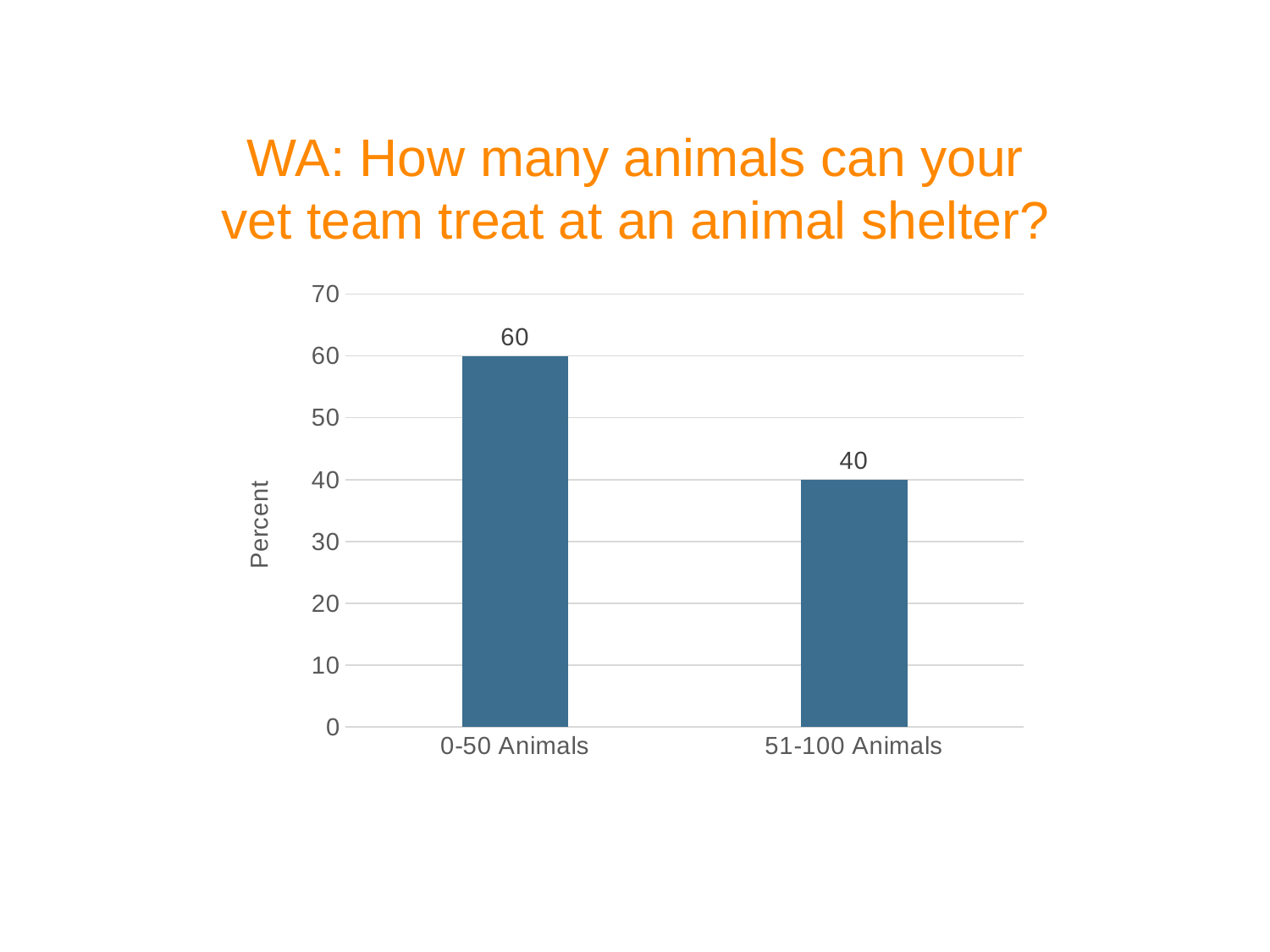
How many categories are shown on the x axis? 2 What is the title of the chart? WA: How many animals can your vet team treat at an animal shelter? What is the value for 0-50 Animals? 60 Is the value for 51-100 Animals greater or less than 50? less Do the values rise or fall from left to right along the x axis? fall What is the difference between the values for 0-50 Animals and 51-100 Animals? 20 Which is larger, the value for 0-50 Animals or the value for 51-100 Animals? 0-50 Animals Which category has the highest value? 0-50 Animals What is the label of the y axis? Percent Which category has the lowest value? 51-100 Animals What is the value for 51-100 Animals? 40 What kind of chart is shown on the slide? bar chart